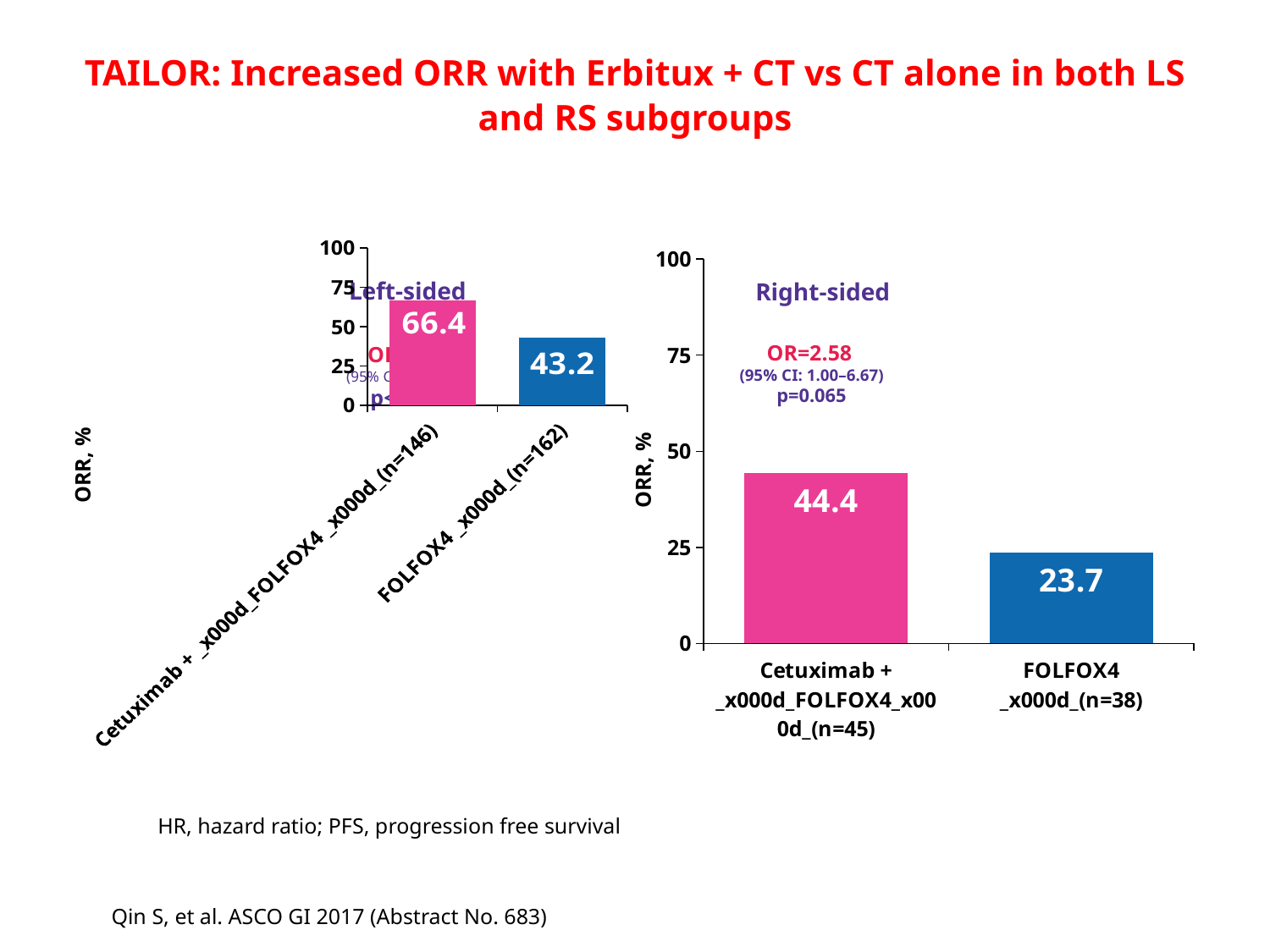
How many bars are shown in the Right-sided chart? 2 What kind of chart is the Right-sided chart? bar chart In the Left-sided chart, what is the difference in ORR between Cetuximab + FOLFOX4 and FOLFOX4? 23.2 In the Right-sided chart, what is the ORR for Cetuximab + FOLFOX4? 44.4 In the Right-sided chart, which treatment has the lower ORR? FOLFOX4 In the Left-sided chart, what is the ORR for FOLFOX4? 43.2 In the Left-sided chart, which treatment has the higher ORR? Cetuximab + FOLFOX4 In the Left-sided chart, what is the ORR for Cetuximab + FOLFOX4? 66.4 In the Right-sided chart, is the value for FOLFOX4 greater or less than 25? less Is the ORR for Cetuximab + FOLFOX4 in the Left-sided chart larger or smaller than the ORR for Cetuximab + FOLFOX4 in the Right-sided chart? larger In the Right-sided chart, what is the ORR for FOLFOX4? 23.7 In the Right-sided chart, what is the difference in ORR between Cetuximab + FOLFOX4 and FOLFOX4? 20.7